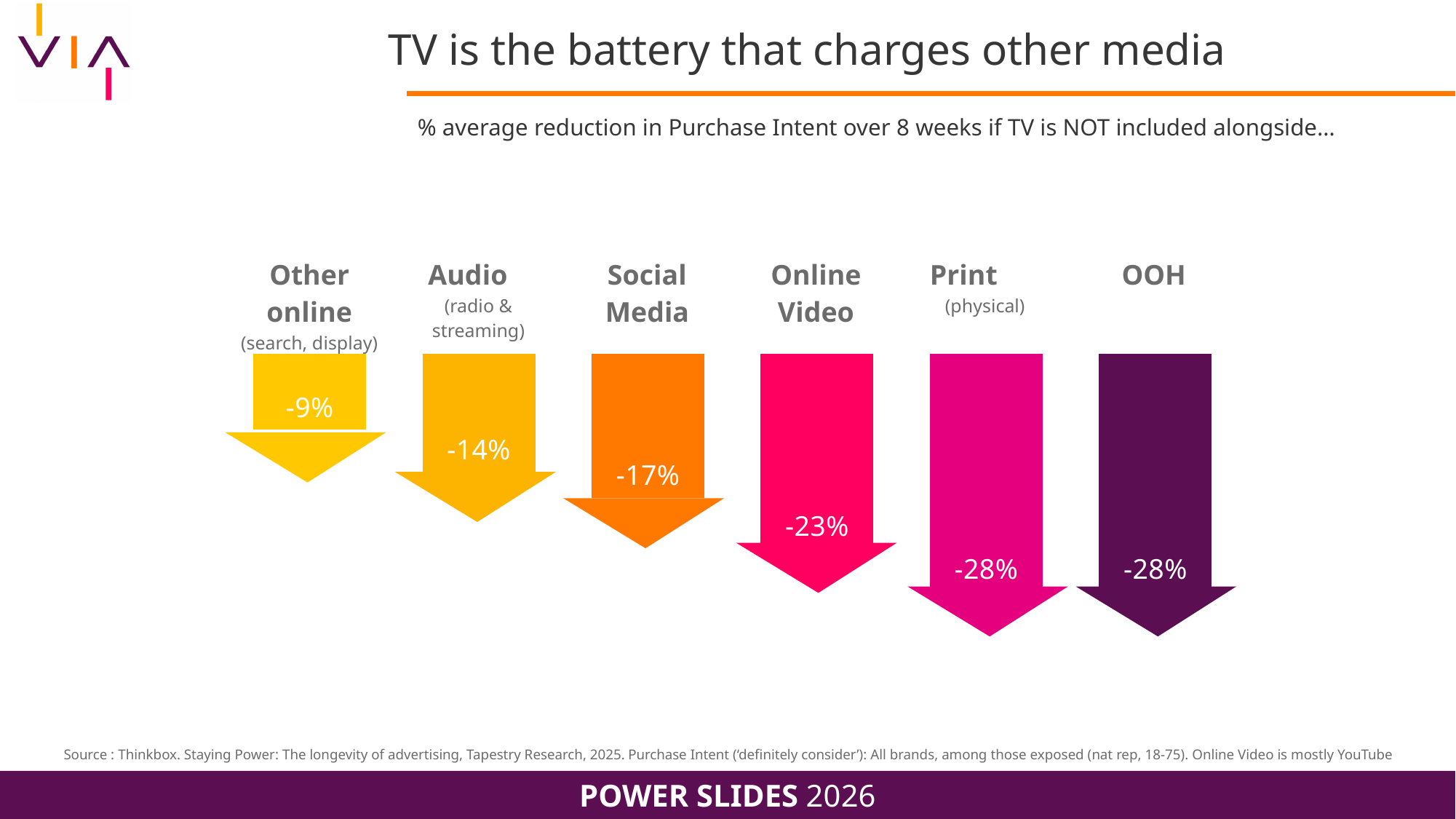
What is the value shown for Social Media? -17% What is the subtitle describing what the chart measures? % average reduction in Purchase Intent over 8 weeks if TV is NOT included alongside... Which category shows the smallest reduction in Purchase Intent? Other online (search, display) What is the value shown for Online Video? -23% Which two categories share the largest reduction in Purchase Intent? Print (physical) and OOH How many media categories are shown in the chart? 6 What is the value shown for OOH? -28% Which shows a larger reduction, Audio or Online Video? Online Video What is the difference between the values for Online Video and Social Media? 6 percentage points What is the value shown for Audio (radio & streaming)? -14% What is the difference between the values for Print (physical) and Other online? 19 percentage points Do the reductions get larger or smaller moving from left to right across the chart? larger